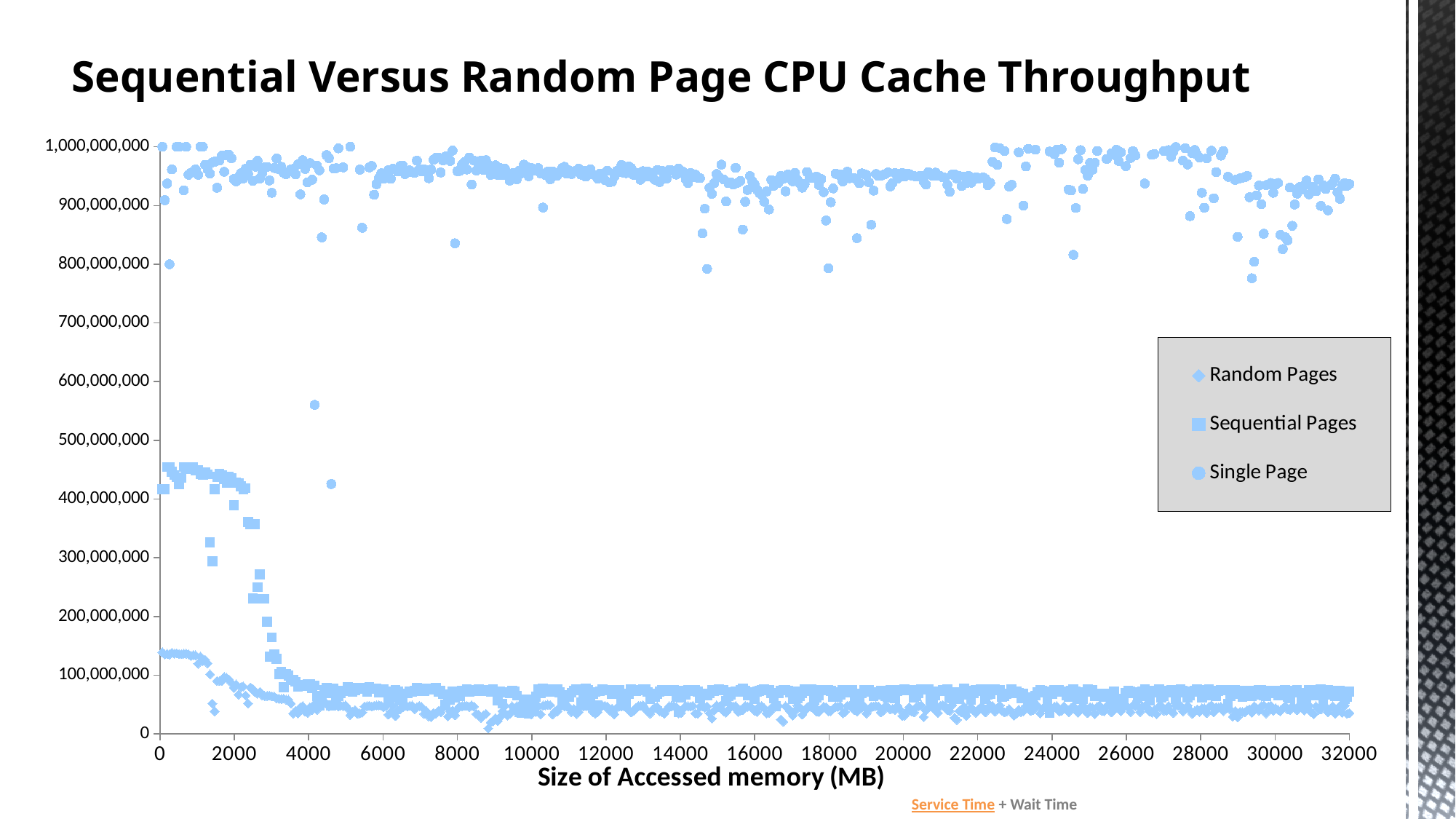
Is the value for Single Page at 16000 MB greater or less than 800,000,000? greater Do the Sequential Pages values rise or fall as the accessed memory size increases from 0 to 4000 MB? fall What kind of chart is shown on the slide? Scatter chart Is the value for Random Pages at 20000 MB greater or less than 100,000,000? less At around 1000 MB, which is larger: Sequential Pages or Random Pages? Sequential Pages What is the label of the x axis? Size of Accessed memory (MB) Which series has the lowest throughput values at around 1000 MB? Random Pages Is the value for Sequential Pages near 0 MB greater or less than 400,000,000? greater Which series has the highest throughput values across the chart? Single Page How many series does the legend list? 3 What is the title of the chart? Sequential Versus Random Page CPU Cache Throughput